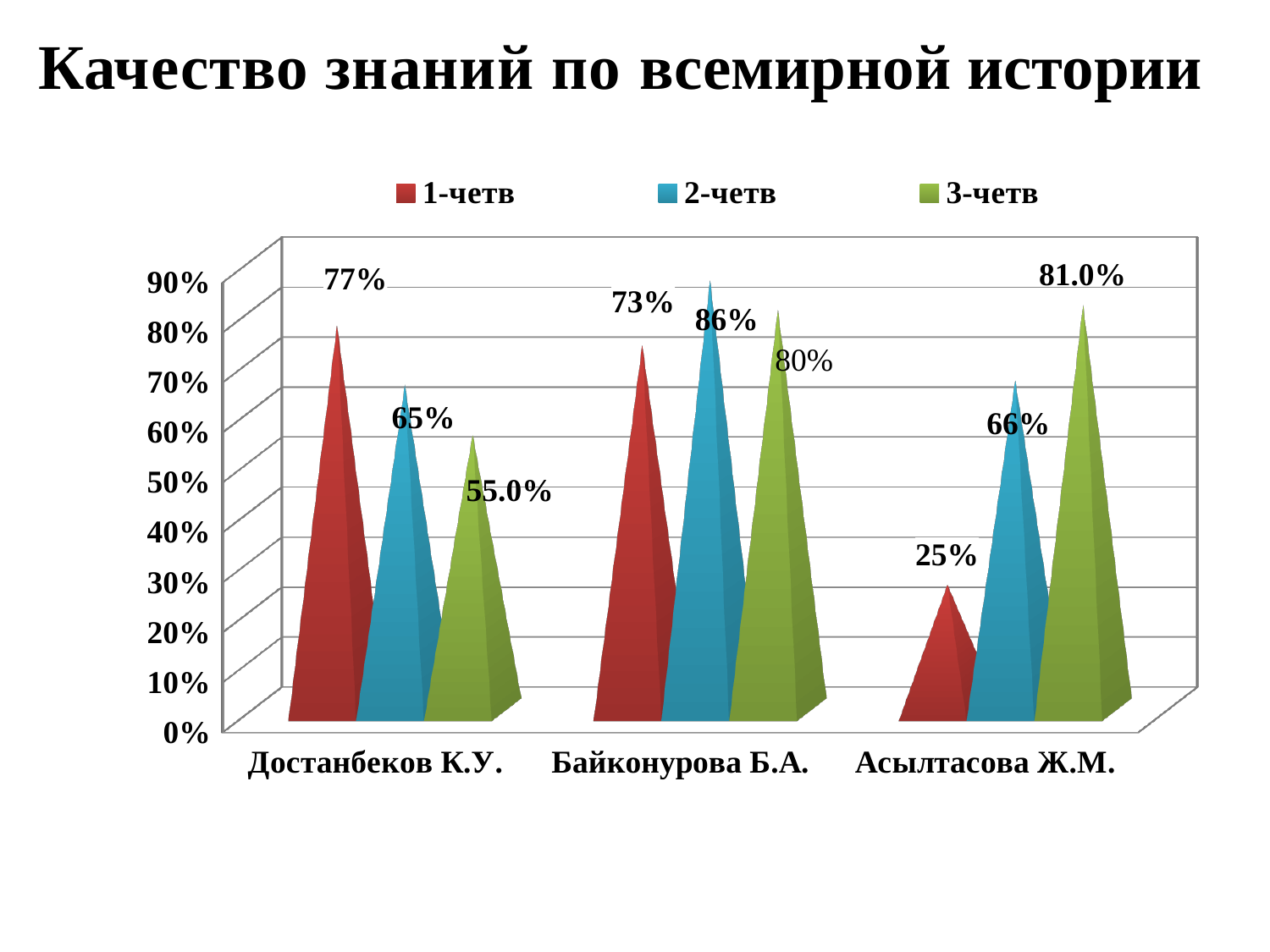
What is the title of the chart? Качество знаний по всемирной истории What is the value for Асылтасова Ж.М. in 3-четв? 81.0% What kind of chart is shown on the slide? Bar chart How many series does the legend list? 3 What is the value for Достанбеков К.У. in 3-четв? 55.0% What is the difference between the 2-четв and 1-четв values for Асылтасова Ж.М.? 41% How many teachers are shown on the x axis? 3 Which teacher has the highest value in 2-четв? Байконурова Б.А. What is the value for Байконурова Б.А. in 2-четв? 86% Which is larger for Байконурова Б.А.: the 1-четв value or the 3-четв value? 3-четв What is the value for Достанбеков К.У. in 1-четв? 77% Which teacher has the lowest value in 1-четв? Асылтасова Ж.М.